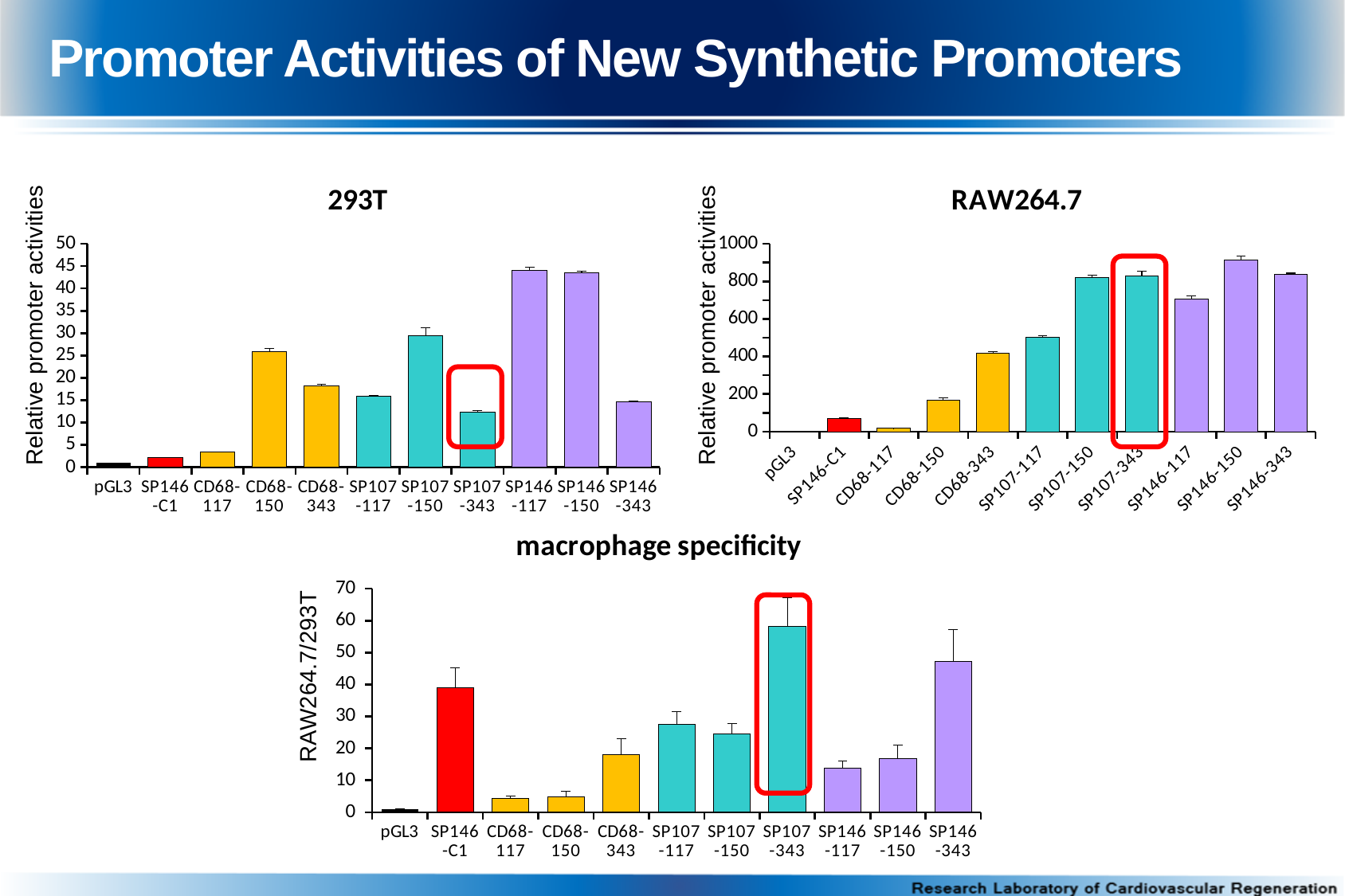
In the RAW264.7 chart, which is larger, SP107-150 or CD68-150? SP107-150 In the macrophage specificity chart, which category has the highest RAW264.7/293T ratio? SP107-343 In the 293T chart, which is larger, SP107-150 or SP107-117? SP107-150 What kind of chart is the RAW264.7 chart? bar chart In the RAW264.7 chart, is the value for SP146-117 greater or less than 800? less In the macrophage specificity chart, is the value for SP146-C1 greater or less than 30? greater In the RAW264.7 chart, which category has the highest relative promoter activity? SP146-150 In the 293T chart, is the value for SP107-343 greater or less than 15? less In the 293T chart, which category has the lowest relative promoter activity? pGL3 How many categories are shown on the x axis of the macrophage specificity chart? 11